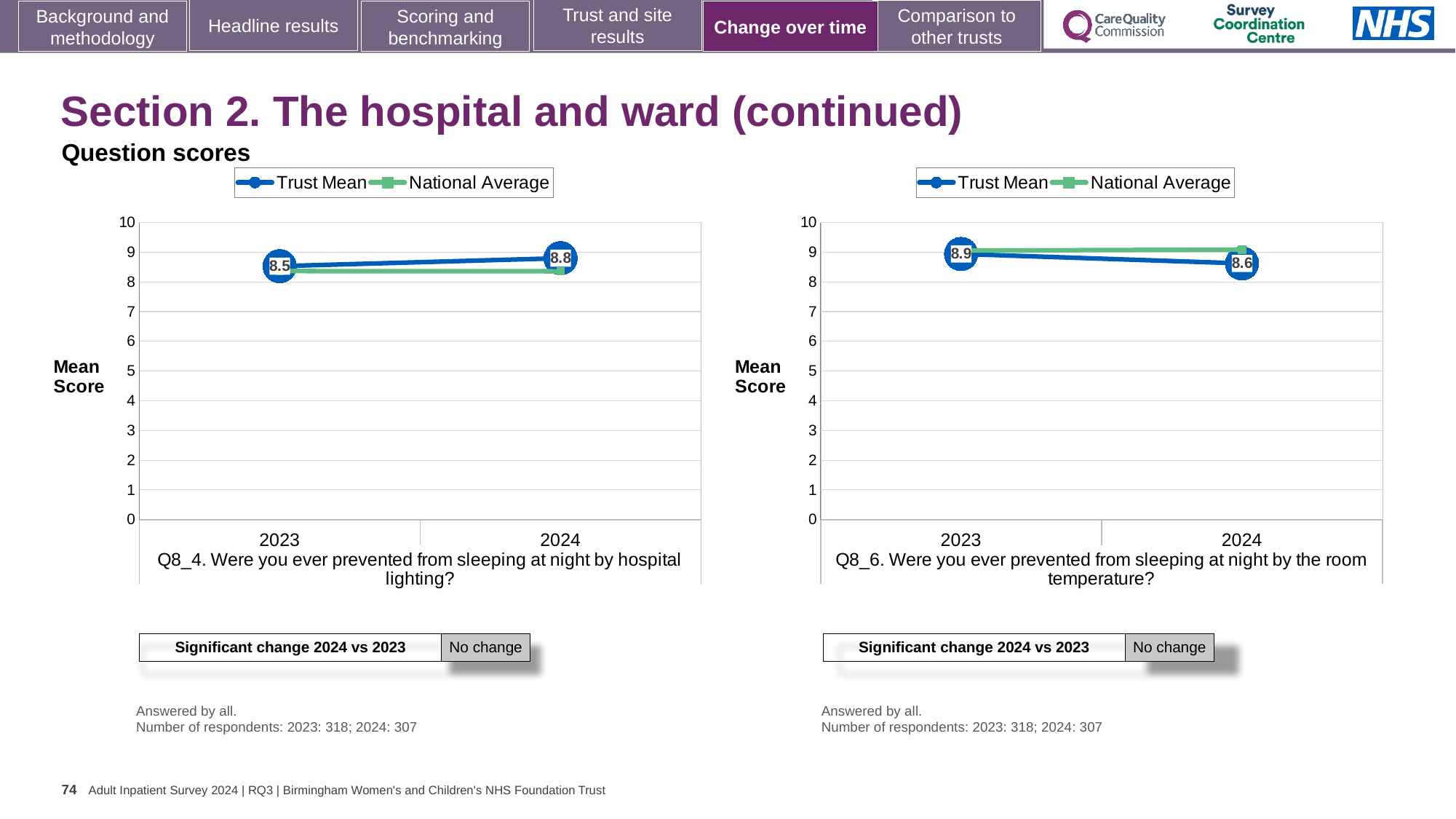
In the Q8_6 room temperature chart, what is the difference between the Trust Mean in 2023 and 2024? 0.3 In the Q8_6 room temperature chart, does the Trust Mean rise or fall from 2023 to 2024? fall In the Q8_6 room temperature chart, what is the Trust Mean score for 2024? 8.6 What type of chart is used for the Q8_4 hospital lighting question? line chart In the Q8_6 room temperature chart, what is the Trust Mean score for 2023? 8.9 How many series does the legend of the Q8_6 room temperature chart list? 2 In the Q8_4 hospital lighting chart, by how much did the Trust Mean change from 2023 to 2024? 0.3 In the Q8_4 hospital lighting chart, what is the Trust Mean score for 2023? 8.5 In the Q8_6 room temperature chart, is the National Average for 2024 greater or less than 8? greater In the Q8_4 hospital lighting chart, what is the Trust Mean score for 2024? 8.8 In the Q8_4 hospital lighting chart, which year has the higher Trust Mean score? 2024 In the Q8_4 hospital lighting chart, does the Trust Mean rise or fall from 2023 to 2024? rise